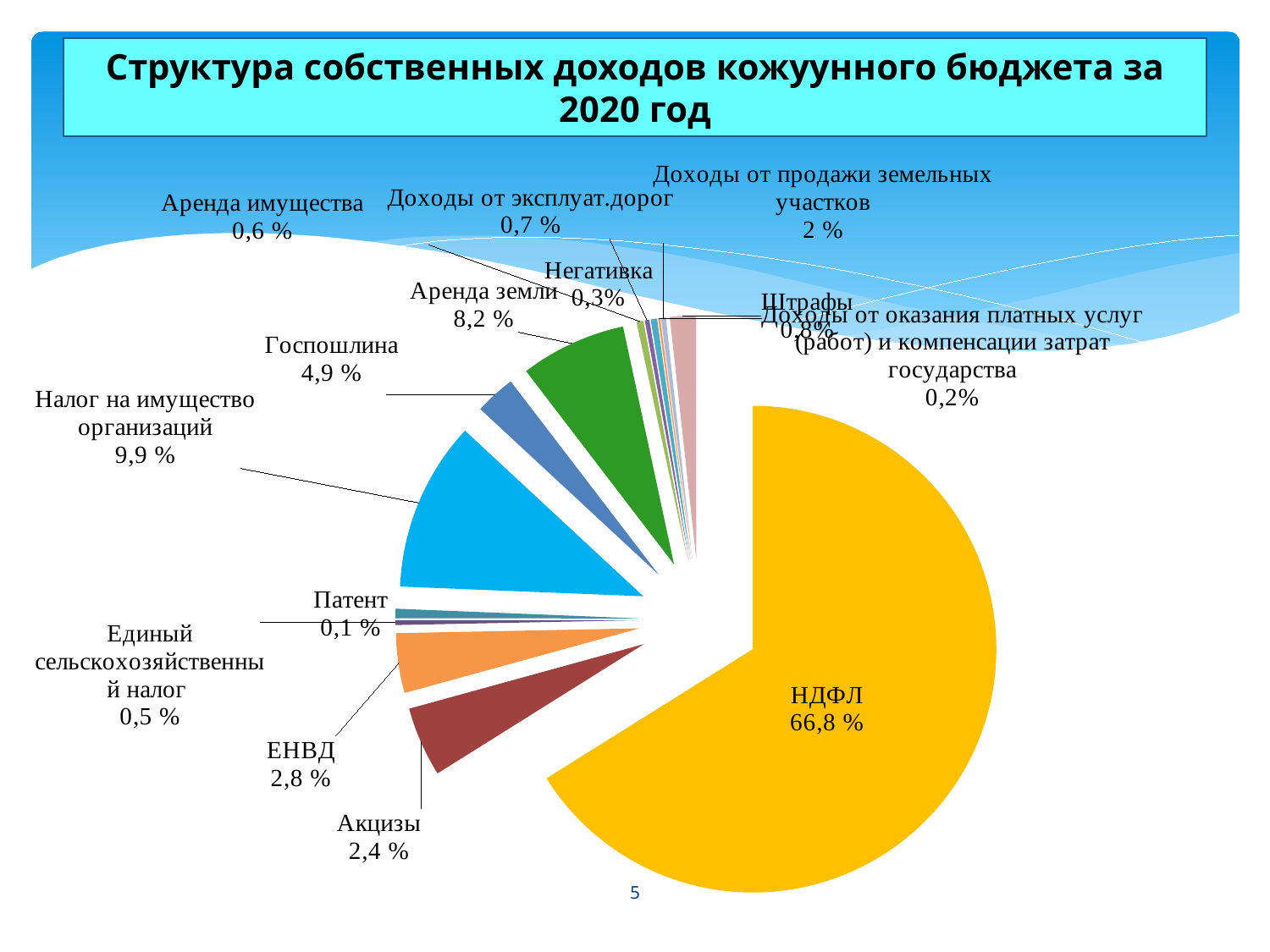
What share of the pie does НДФЛ account for? 66,8 % Which category has the largest share of the pie? НДФЛ What is the value shown for Госпошлина? 4,9 % What is the title of the chart on the slide? Структура собственных доходов кожуунного бюджета за 2020 год What is the value shown for Аренда земли? 8,2 % What is the value shown for Акцизы? 2,4 % What is the value shown for Доходы от продажи земельных участков? 2 % What is the value shown for Налог на имущество организаций? 9,9 % What kind of chart is shown on the slide? pie chart Which is larger, ЕНВД or Акцизы? ЕНВД Which category has the smallest share of the pie? Патент What is the difference between the shares of Налог на имущество организаций and Аренда земли? 1,7 %